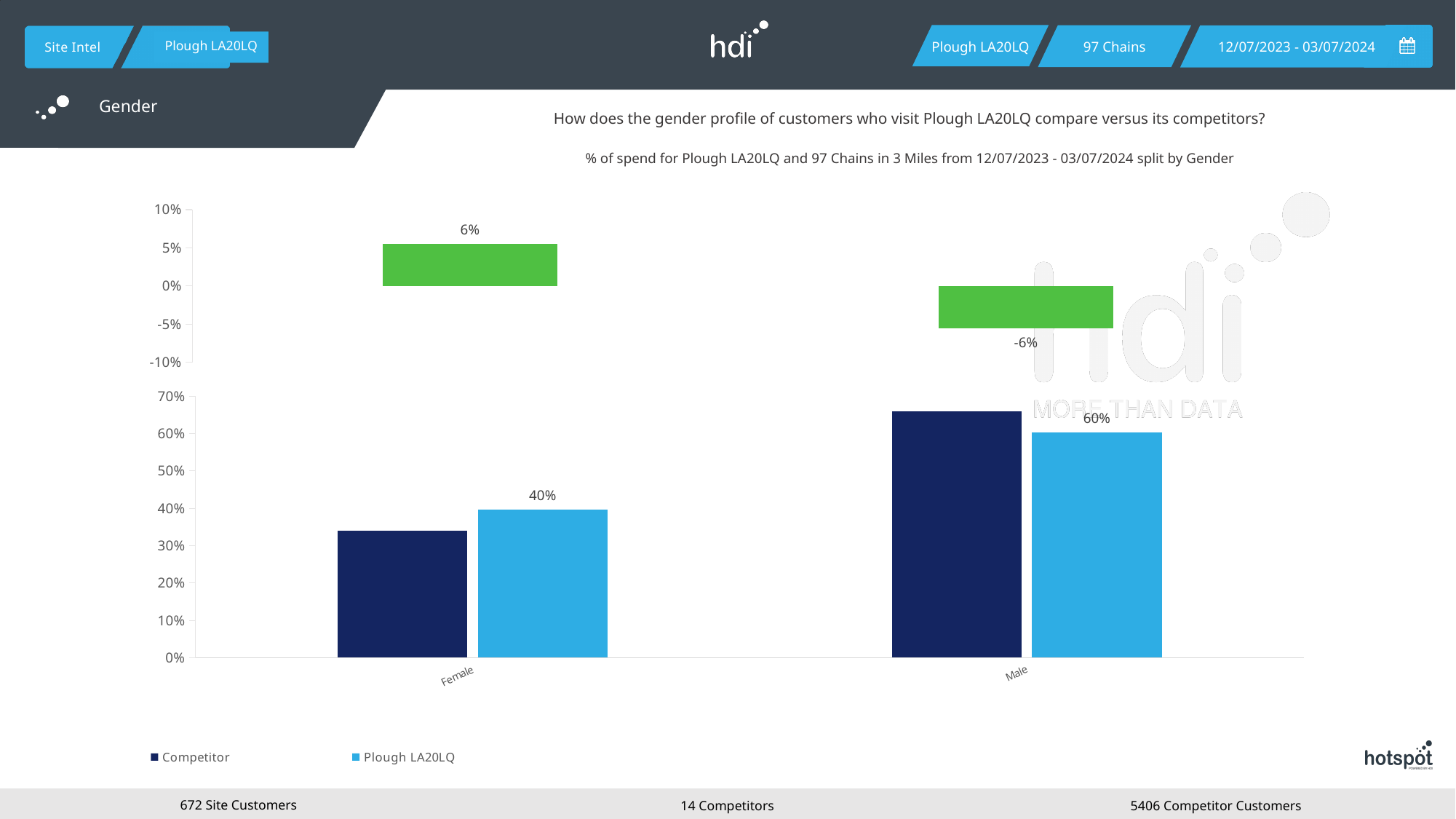
In the bottom chart, which series has the higher value in the Male category, Competitor or Plough LA20LQ? Competitor In the bottom chart, which category has the higher value for Plough LA20LQ, Female or Male? Male In the bottom chart, what is the difference between the Plough LA20LQ values for Male and Female? 20% In the top chart, what is the value shown for the Male category? -6% In the bottom chart, is the Competitor value for Male greater or less than 60%? greater How many series does the legend of the bottom chart list? 2 How many categories are shown on the x axis of the bottom chart? 2 In the bottom chart, is the Competitor value for Female greater or less than 40%? less What kind of chart is the bottom chart? bar chart In the top chart, what is the value shown for the Female category? 6% In the bottom chart, what is the value for Plough LA20LQ in the Female category? 40% In the bottom chart, what is the value for Plough LA20LQ in the Male category? 60%